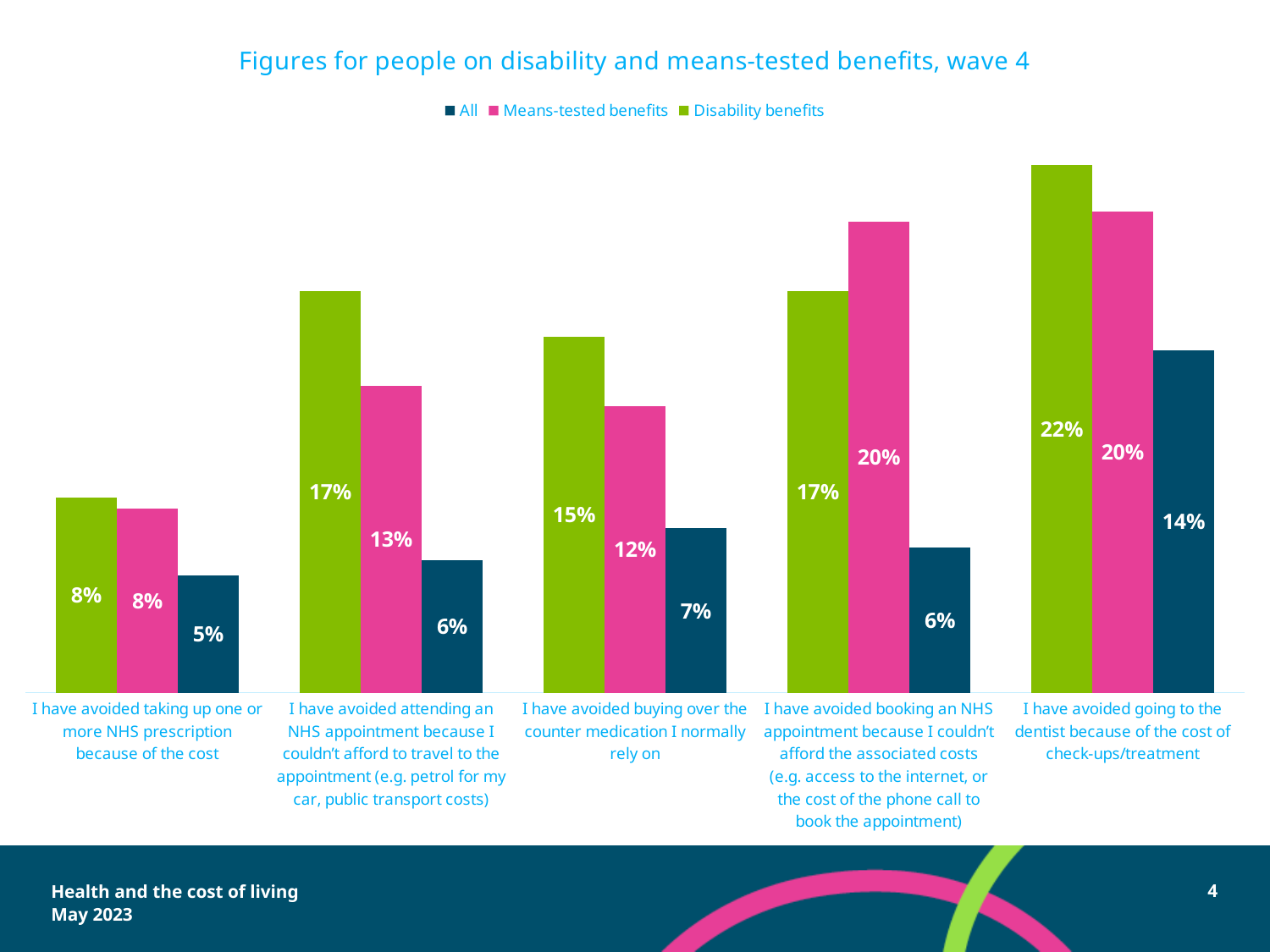
How many series does the legend list? 3 What is the difference between the Means-tested benefits value and the All value for 'I have avoided booking an NHS appointment because I couldn't afford the associated costs'? 14% Which category has the lowest value for Disability benefits? I have avoided taking up one or more NHS prescription because of the cost Which category has the highest value for the All series? I have avoided going to the dentist because of the cost of check-ups/treatment What kind of chart is shown on the slide? Bar chart What is the value for Means-tested benefits for 'I have avoided buying over the counter medication I normally rely on'? 12% What is the value for Disability benefits for 'I have avoided going to the dentist because of the cost of check-ups/treatment'? 22% What is the difference between the Disability benefits value and the All value for 'I have avoided attending an NHS appointment because I couldn't afford to travel to the appointment'? 11% What is the title of the chart? Figures for people on disability and means-tested benefits, wave 4 How many categories are shown on the x axis? 5 For 'I have avoided booking an NHS appointment because I couldn't afford the associated costs', which is larger: Disability benefits or Means-tested benefits? Means-tested benefits What is the value for All for 'I have avoided taking up one or more NHS prescription because of the cost'? 5%